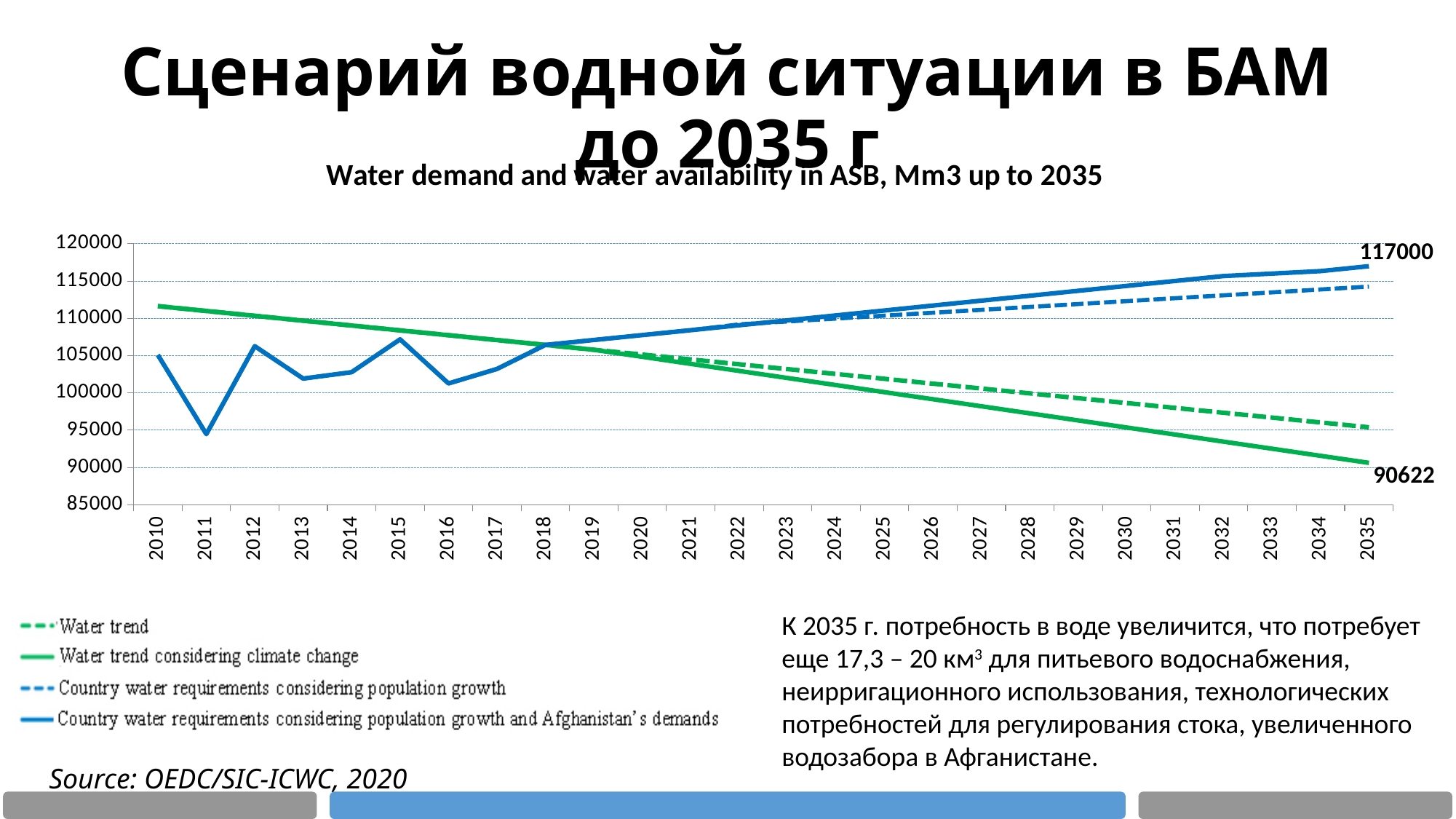
Is the value for 'Country water requirements considering population growth' in 2035 greater or less than 110000? greater Does the 'Water trend considering climate change' line rise or fall from 2010 to 2035? Fall What is the title of the chart? Water demand and water availability in ASB, Mm3 up to 2035 What is the value of 'Water trend considering climate change' in 2035? 90622 Which series has the lowest value in 2035? Water trend considering climate change What is the value of 'Country water requirements considering population growth and Afghanistan's demands' in 2035? 117000 What is the difference between the 2035 values of 'Country water requirements considering population growth and Afghanistan's demands' and 'Water trend considering climate change'? 26378 Which series has the highest value in 2035? Country water requirements considering population growth and Afghanistan's demands What type of chart is shown on the slide? Line chart Is the value for 'Country water requirements considering population growth and Afghanistan's demands' in 2010 greater or less than 100000? greater How many series does the chart legend list? 4 How many years are shown on the x axis? 26